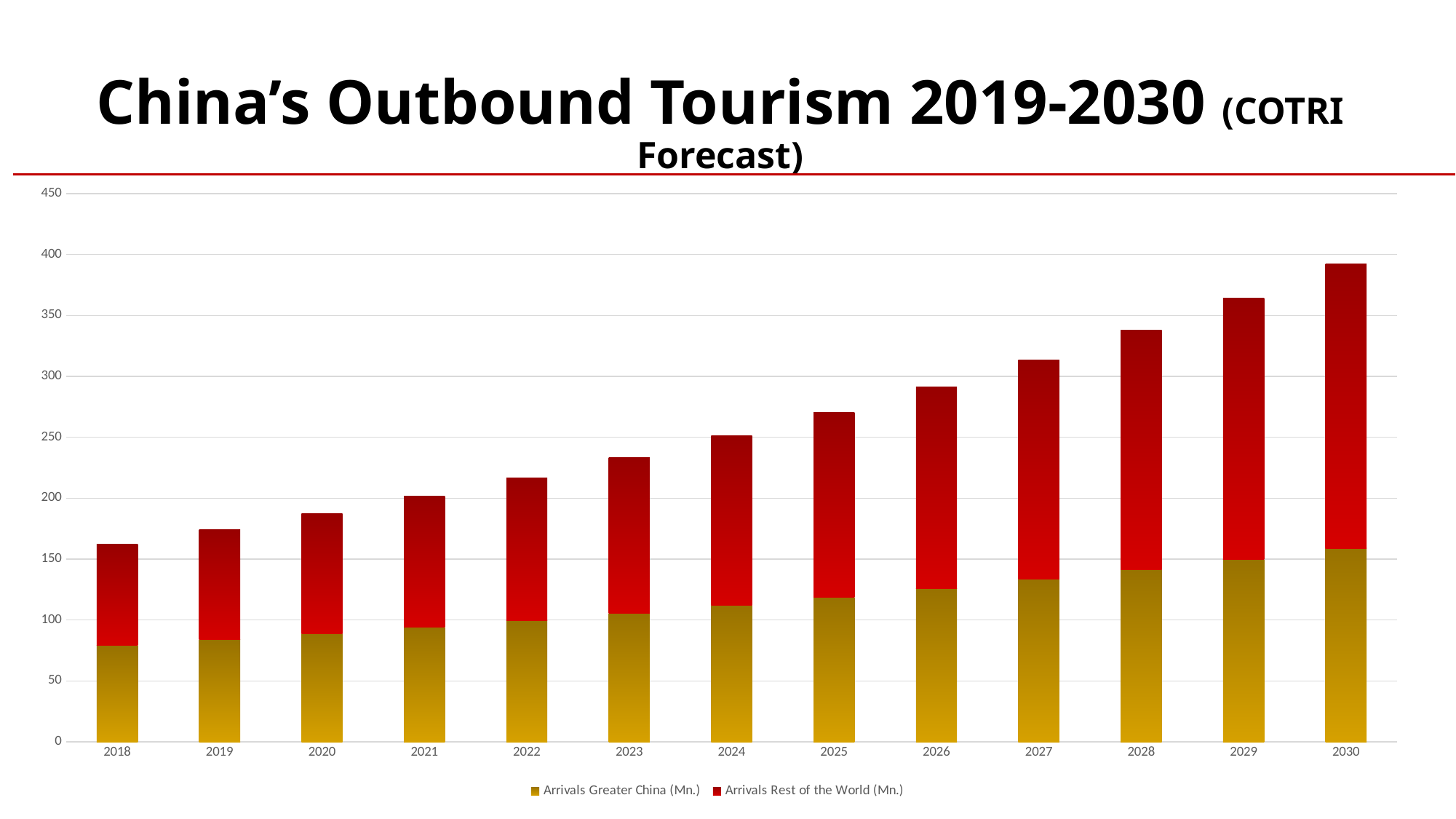
Which year has the lowest total stacked bar? 2018 Which year has the highest total stacked bar? 2030 Do the total arrivals rise or fall from 2018 to 2030? Rise What kind of chart is shown on the slide? Stacked bar chart Which is larger, the total stacked bar for 2018 or for 2030? 2030 Which series is shown in red in the chart? Arrivals Rest of the World (Mn.) How many years are shown along the x axis of the chart? 13 Is the Arrivals Greater China (Mn.) value for 2018 greater or less than 100? less How many series does the chart's legend list? 2 Is the total stacked bar for 2023 greater or less than 250? less Is the Arrivals Greater China (Mn.) value for 2030 greater or less than 150? greater